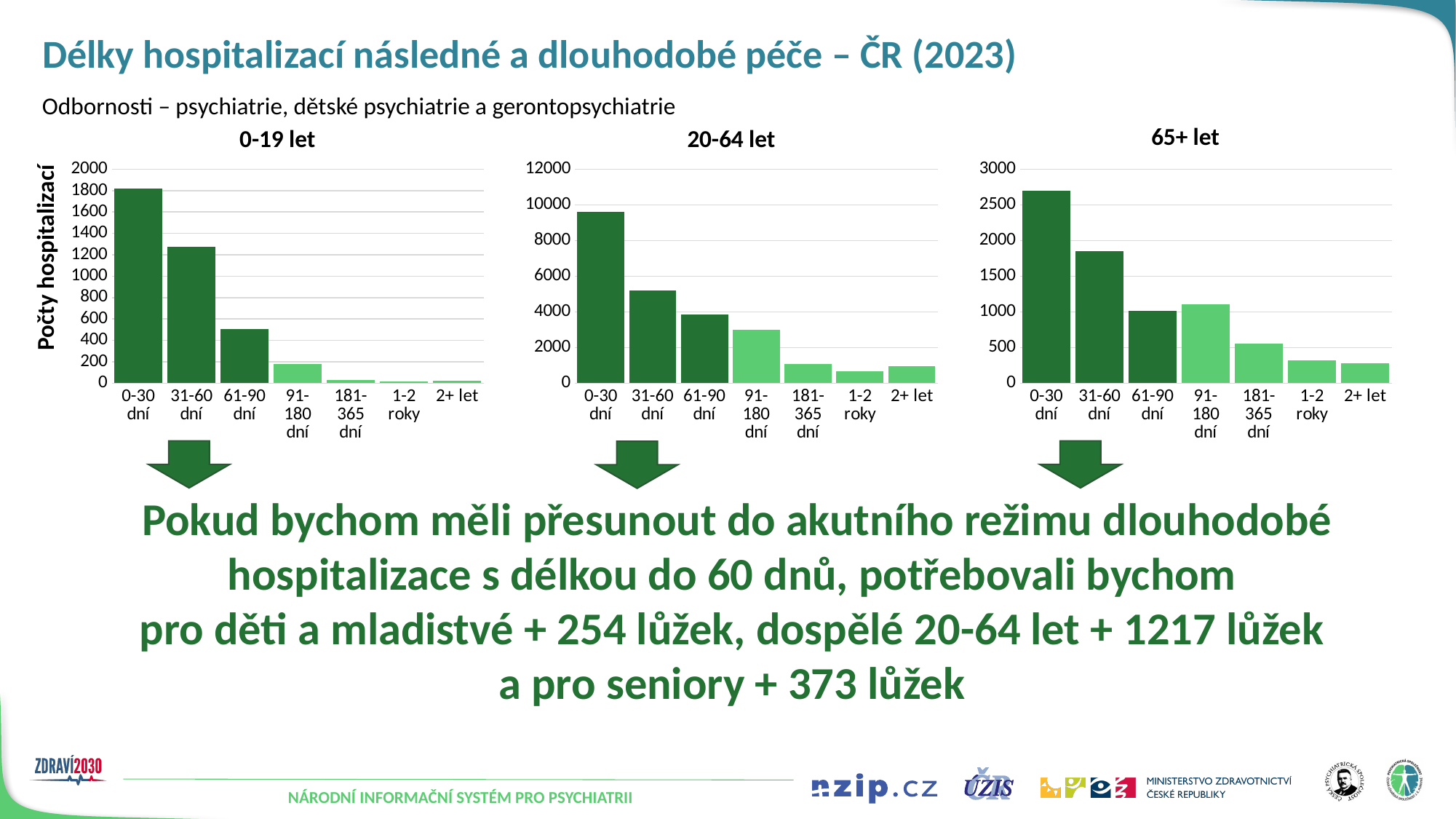
In the 65+ let chart, is the value for 0-30 dní greater or less than 2500? greater In the 65+ let chart, which category has the highest value? 0-30 dní In the 65+ let chart, which is larger, the value for 31-60 dní or the value for 61-90 dní? 31-60 dní What kind of chart is the 65+ let chart? bar chart In the 20-64 let chart, is the value for 31-60 dní greater or less than 6000? less In the 20-64 let chart, which category has the highest value? 0-30 dní In the 0-19 let chart, is the value for 61-90 dní greater or less than 600? less In the 20-64 let chart, which category has the lowest value? 1-2 roky How many categories are shown on the x axis of the 20-64 let chart? 7 In the 0-19 let chart, which category has the highest value? 0-30 dní